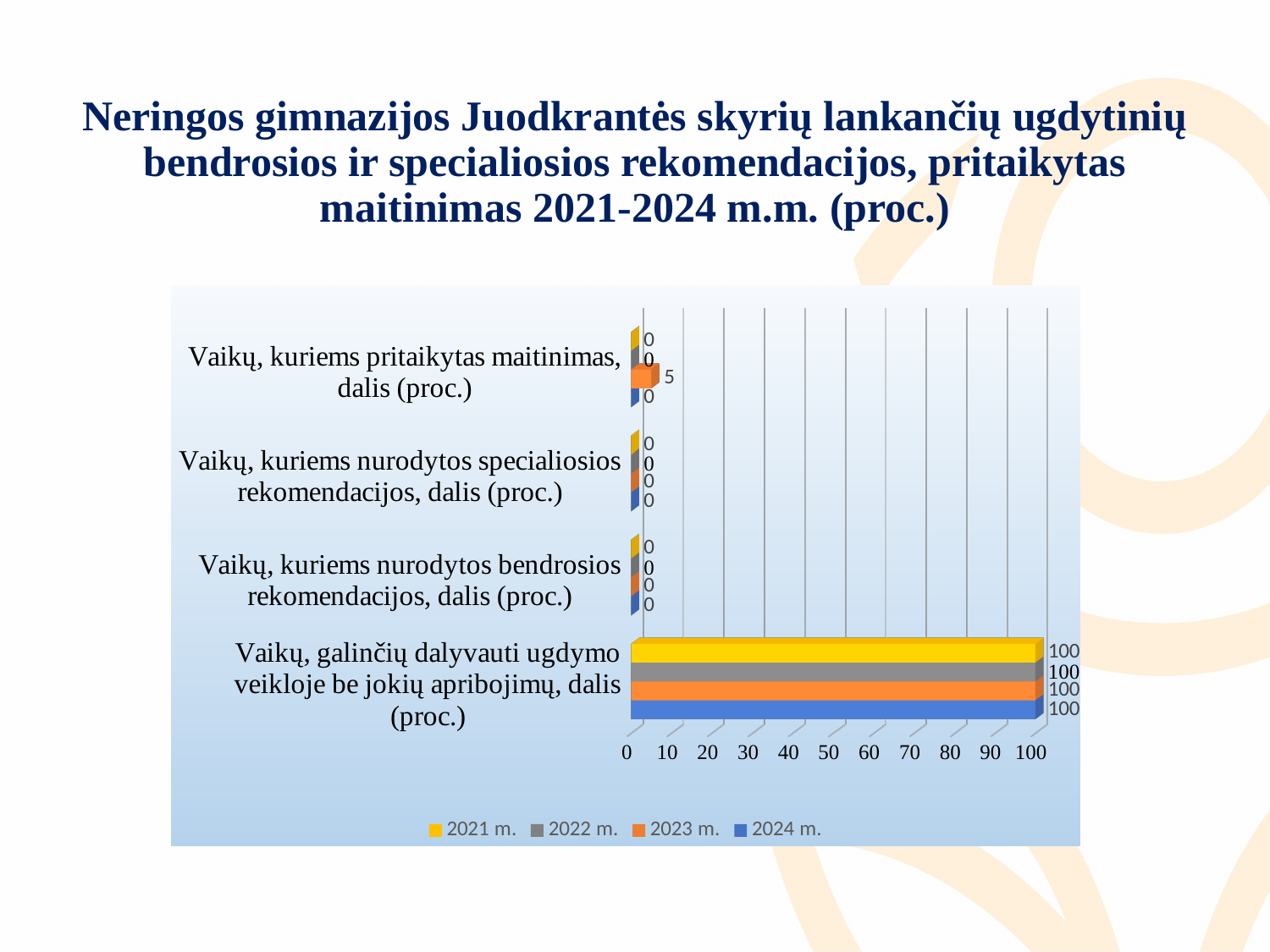
What colour represents the 2021 m. series in the legend? yellow How many categories are shown on the chart? 4 What is the value for 2023 m. in the category "Vaikų, kuriems pritaikytas maitinimas, dalis (proc.)"? 5 What kind of chart is shown on the slide? bar chart What is the value for 2024 m. in the category "Vaikų, kuriems nurodytos bendrosios rekomendacijos, dalis (proc.)"? 0 How many series does the legend list? 4 What is the difference between the 2023 m. value and the 2024 m. value in the category "Vaikų, kuriems pritaikytas maitinimas, dalis (proc.)"? 5 Which category has the highest values across all series? Vaikų, galinčių dalyvauti ugdymo veikloje be jokių apribojimų, dalis (proc.) What is the value for 2022 m. in the category "Vaikų, kuriems nurodytos specialiosios rekomendacijos, dalis (proc.)"? 0 Which is larger for 2023 m.: the value for "Vaikų, galinčių dalyvauti ugdymo veikloje be jokių apribojimų, dalis (proc.)" or the value for "Vaikų, kuriems pritaikytas maitinimas, dalis (proc.)"? Vaikų, galinčių dalyvauti ugdymo veikloje be jokių apribojimų, dalis (proc.) What is the value for 2021 m. in the category "Vaikų, galinčių dalyvauti ugdymo veikloje be jokių apribojimų, dalis (proc.)"? 100 Which series has the highest value in the category "Vaikų, kuriems pritaikytas maitinimas, dalis (proc.)"? 2023 m.